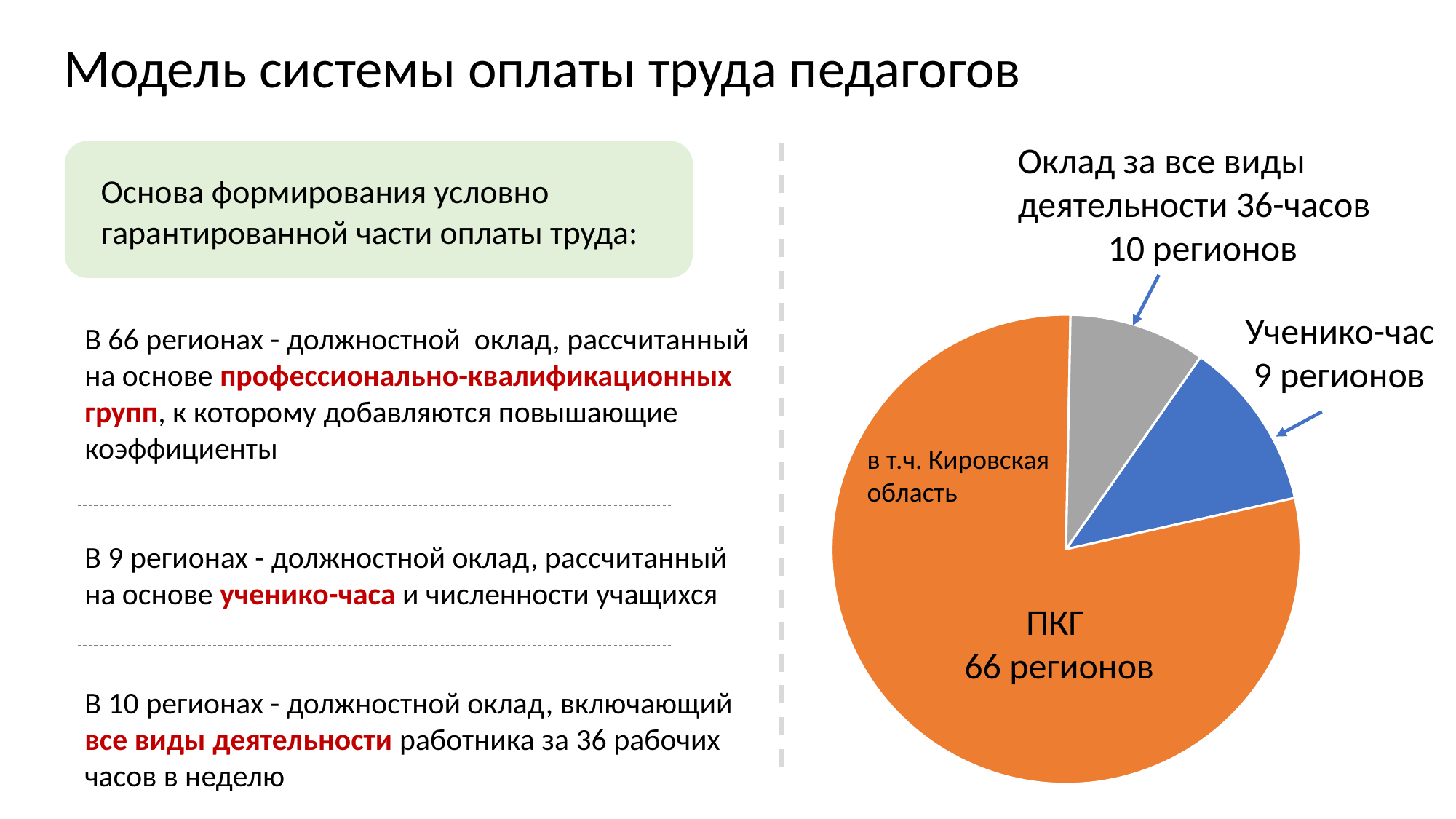
How many more regions are in the ПКГ slice than in the Ученико-час slice? 57 How many regions are in the ПКГ slice of the pie chart? 66 регионов How many regions are in the slice 'Оклад за все виды деятельности 36-часов'? 10 регионов What colour is the ПКГ slice of the pie chart? Orange Which slice of the pie chart represents the largest number of regions? ПКГ Which has more regions: Ученико-час or Оклад за все виды деятельности 36-часов? Оклад за все виды деятельности 36-часов How many regions are in the Ученико-час slice of the pie chart? 9 регионов How many slices does the pie chart have? 3 Which slice of the pie chart represents the smallest number of regions? Ученико-час What kind of chart is shown on the slide? Pie chart What is the total number of regions across all slices of the pie chart? 85 Which region is specifically noted inside the ПКГ slice of the pie chart? Кировская область